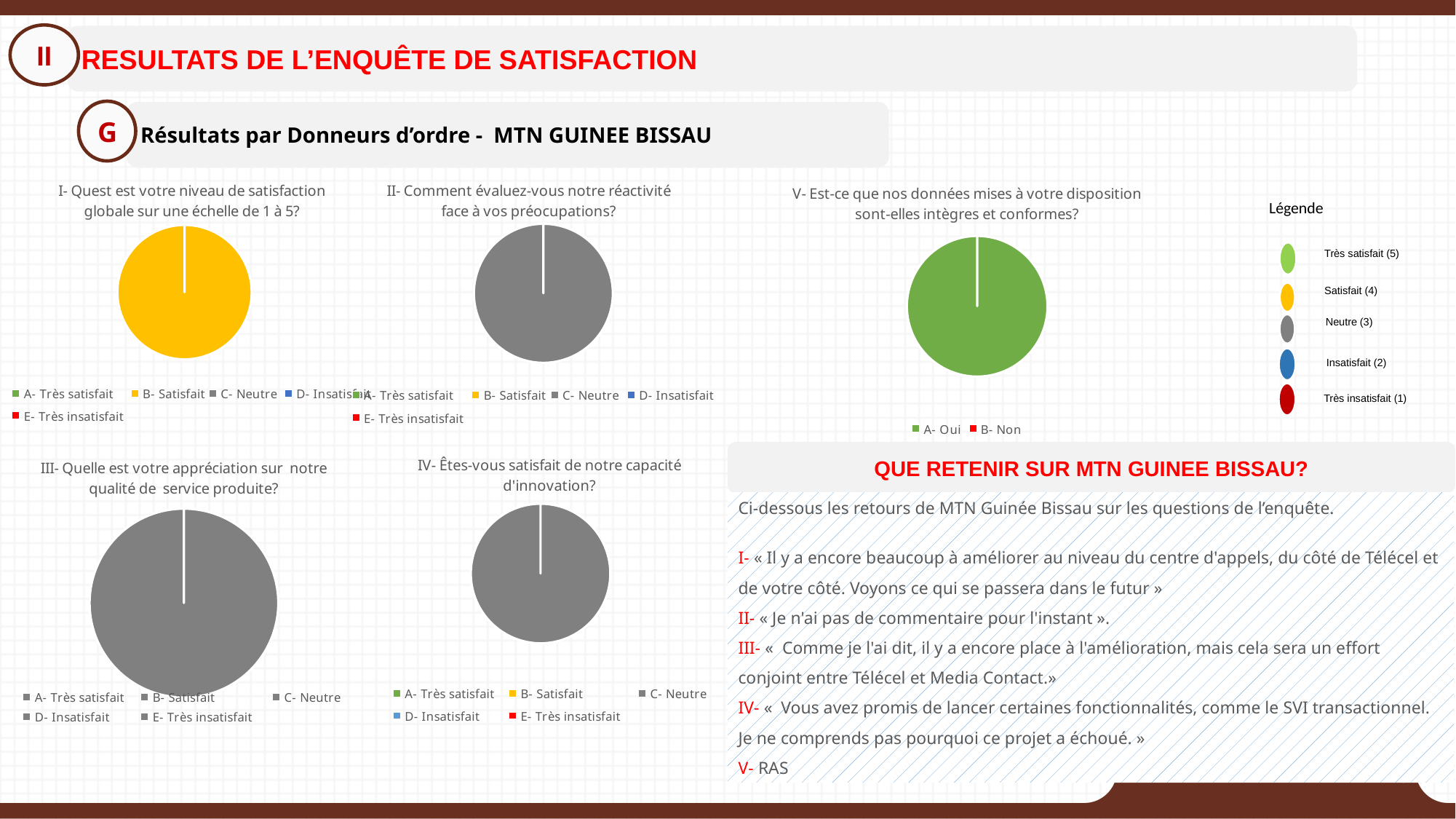
How many entries does the legend of the chart for question IV (capacité d'innovation) list? 5 How many entries does the legend of the chart for question I (niveau de satisfaction globale) list? 5 What colour is the pie in the chart for question V (données intègres et conformes)? green In the chart for question I (niveau de satisfaction globale), which category makes up the entire pie? B- Satisfait How many entries does the legend of the chart for question V (données intègres et conformes) list? 2 In the chart for question V (données intègres et conformes), which category makes up the entire pie? A- Oui In the chart for question II (réactivité face à vos préocupations), which category makes up the entire pie? C- Neutre How many pie charts are shown on the slide? 5 What kind of chart is used for question I (niveau de satisfaction globale)? pie chart What colour is the pie in the chart for question I (niveau de satisfaction globale)? yellow